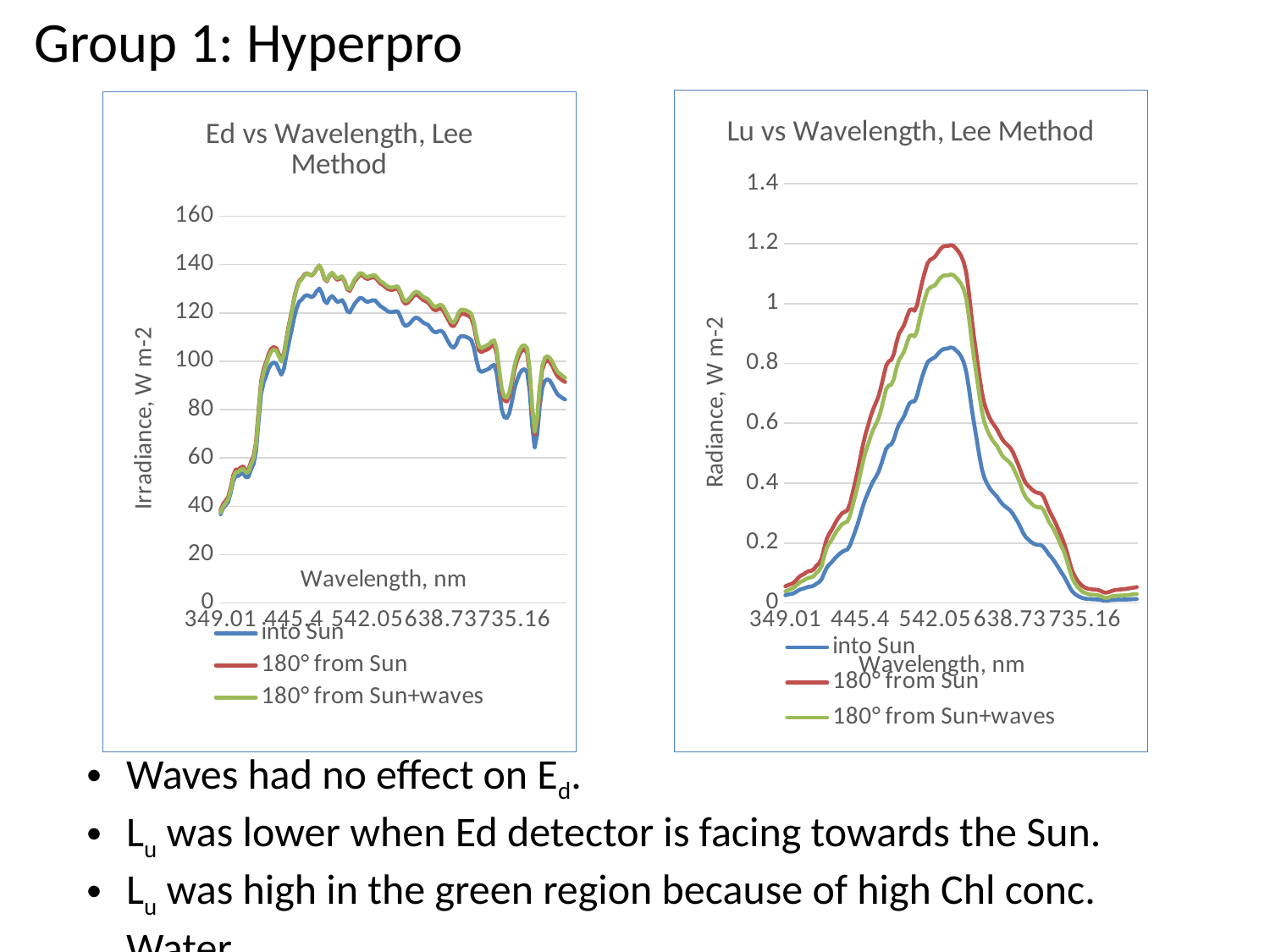
In the 'Ed vs Wavelength, Lee Method' chart, is the peak value of the 'into Sun' series greater or less than 120? greater What kind of chart is the 'Ed vs Wavelength, Lee Method' chart on the left? line chart In the 'Ed vs Wavelength, Lee Method' chart, what are the three series named in the legend? into Sun, 180° from Sun, 180° from Sun+waves What is the y-axis label of the 'Lu vs Wavelength, Lee Method' chart? Radiance, W m-2 In the 'Lu vs Wavelength, Lee Method' chart, is the peak value of the 'into Sun' series greater or less than 1? less In the 'Lu vs Wavelength, Lee Method' chart, do the values rise or fall from the peak near 542.05 nm toward 735.16 nm? fall In the 'Lu vs Wavelength, Lee Method' chart, which series reaches the highest radiance? 180° from Sun How many series does the legend of the 'Lu vs Wavelength, Lee Method' chart list? 3 In the 'Ed vs Wavelength, Lee Method' chart, is the value of the 'into Sun' series at 349.01 nm greater or less than 60? less In the 'Ed vs Wavelength, Lee Method' chart, which series has the higher peak irradiance, 'into Sun' or '180° from Sun'? 180° from Sun In the 'Lu vs Wavelength, Lee Method' chart, which series has the lowest peak radiance? into Sun